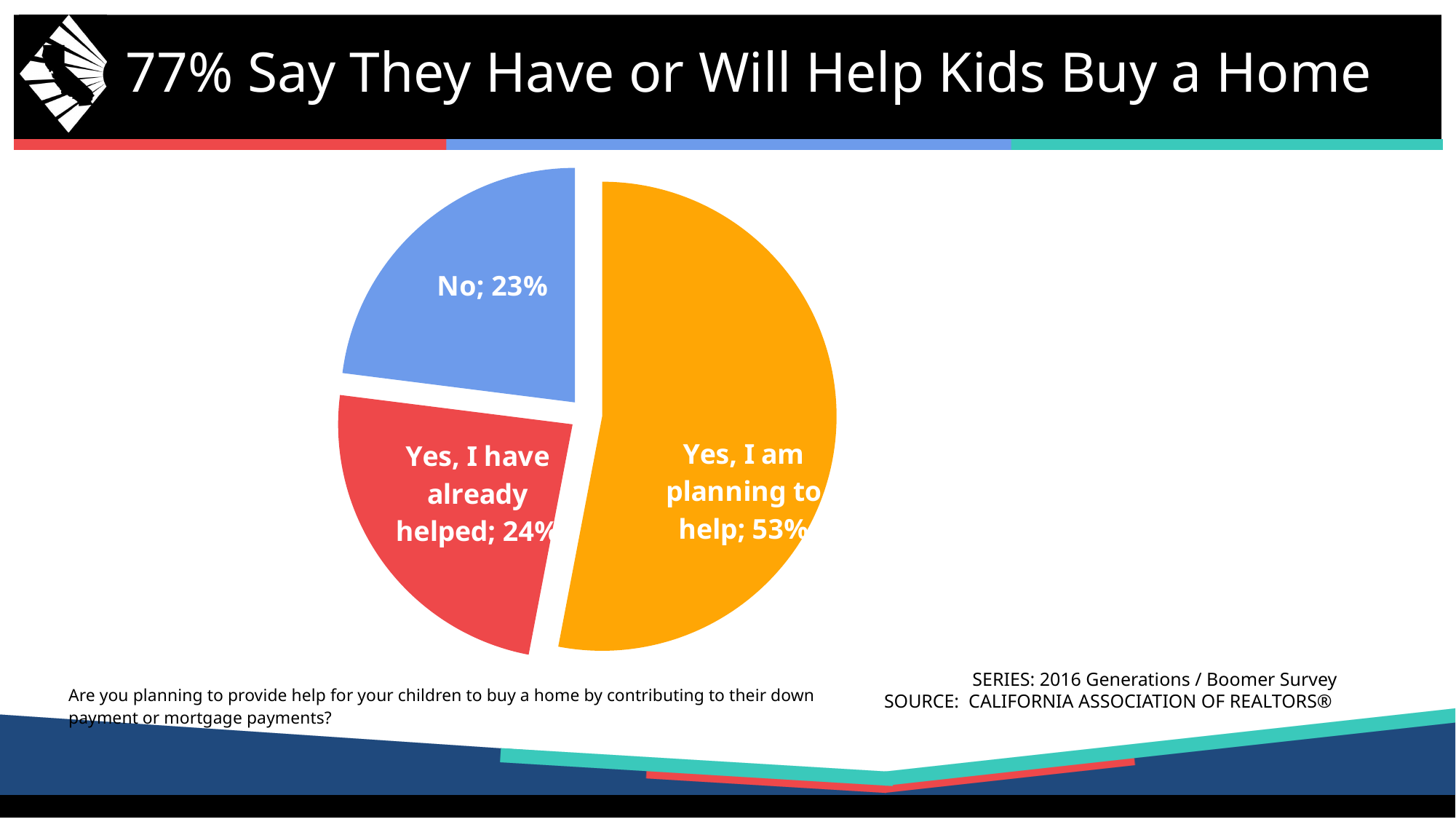
What kind of chart is shown on the slide? pie chart Which response has the smallest share of the pie? No Which is larger: the share for "Yes, I am planning to help" or the share for "No"? Yes, I am planning to help What is the combined percentage of the two "Yes" responses? 77% What percentage of respondents said "Yes, I have already helped"? 24% What is the title of the slide containing the pie chart? 77% Say They Have or Will Help Kids Buy a Home How many slices does the pie chart have? 3 What colour is the "No" slice of the pie? blue What percentage of respondents said "Yes, I am planning to help"? 53% Which response has the largest share of the pie? Yes, I am planning to help What percentage of respondents said "No"? 23% What is the difference in percentage points between "Yes, I am planning to help" and "Yes, I have already helped"? 29